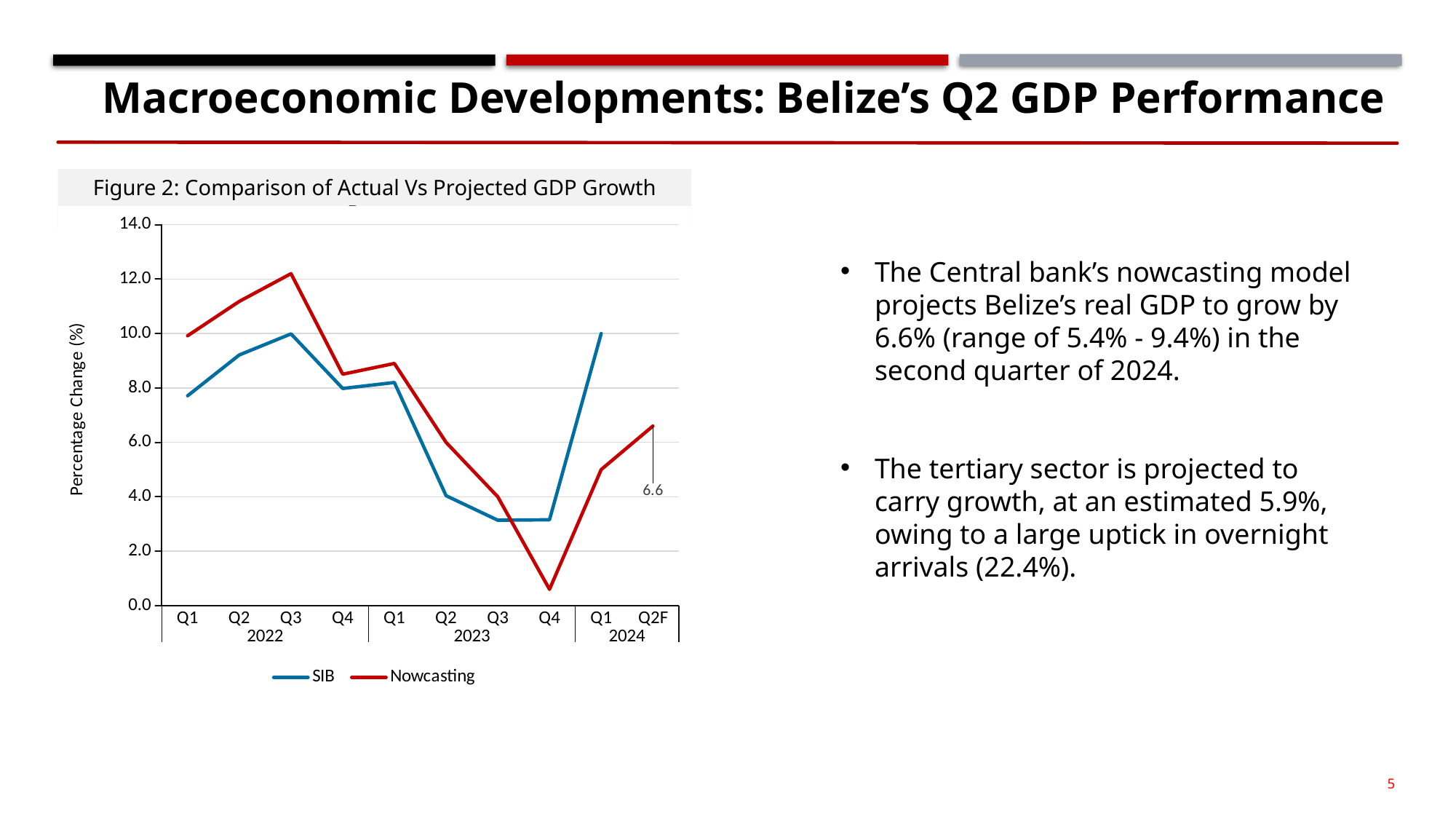
In which quarter does the Nowcasting series reach its lowest value in Figure 2? Q4 2023 What is the labelled Nowcasting value for Q2F 2024 in Figure 2? 6.6 Is the SIB value for Q2 2023 greater or less than 6.0? less Is the Nowcasting value for Q4 2023 greater or less than 2.0? less How many quarters are shown on the x axis of Figure 2? 10 In Q3 2022, which series has the higher value, SIB or Nowcasting? Nowcasting In Q1 2024, which series has the higher value, SIB or Nowcasting? SIB Is the Nowcasting value for Q3 2022 greater or less than 10.0? greater What kind of chart is Figure 2: Comparison of Actual Vs Projected GDP Growth? Line chart How many series does the legend of Figure 2 list? 2 What is the label on the y axis of Figure 2? Percentage Change (%) In which quarter does the Nowcasting series reach its highest value in Figure 2? Q3 2022